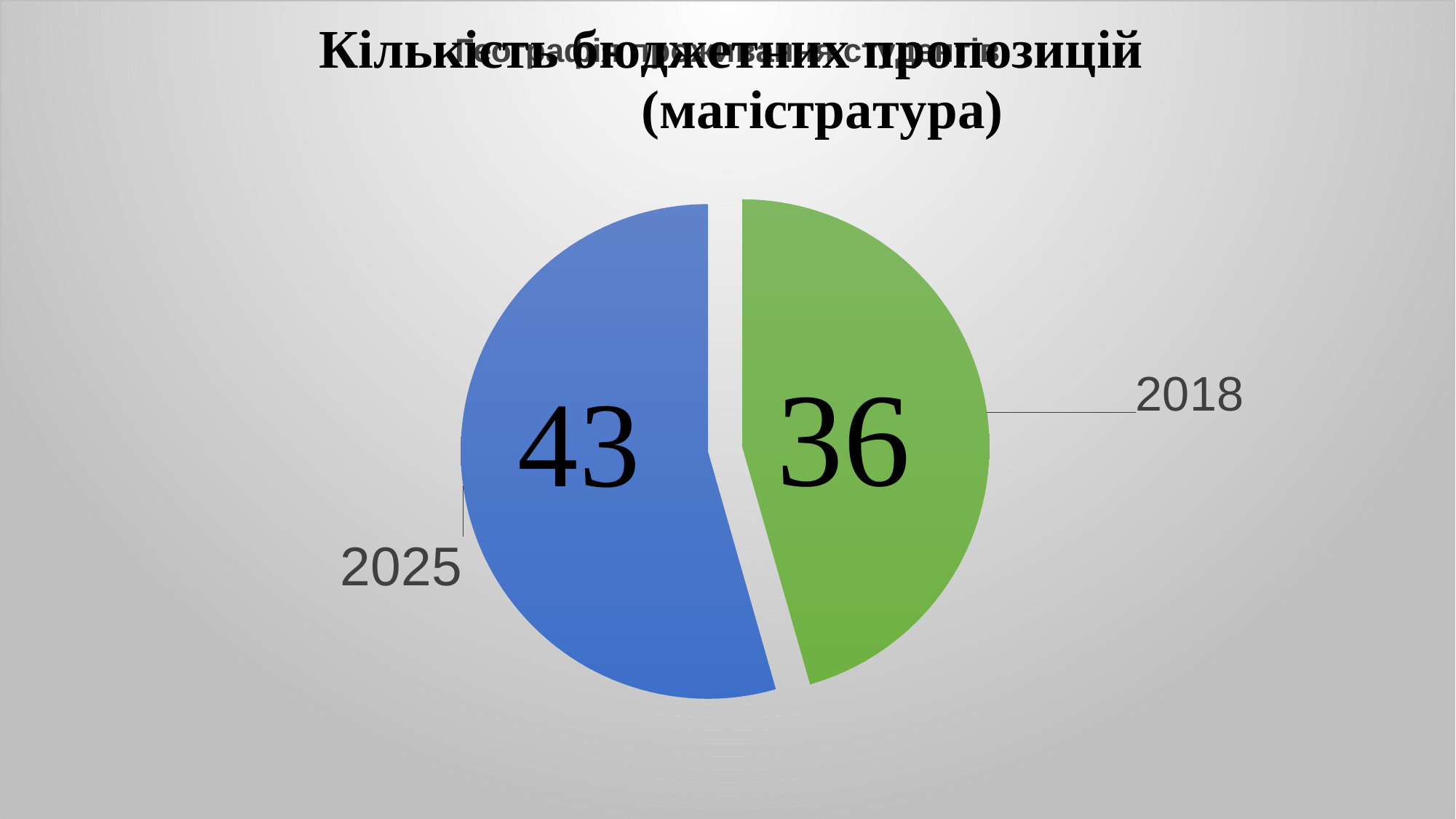
Which category has the largest slice in the pie chart? 2025 What colour is the slice for 2018? green What is the value for 2018 in the pie chart? 36 Which category has the smallest slice in the pie chart? 2018 How many slices does the pie chart have? 2 What type of chart is shown on the slide? pie chart What is the value for 2025 in the pie chart? 43 What colour is the slice for 2025? blue What is the difference between the values for 2025 and 2018? 7 Which is larger, the value for 2025 or the value for 2018? 2025 What is the total of the two values shown in the pie chart? 79